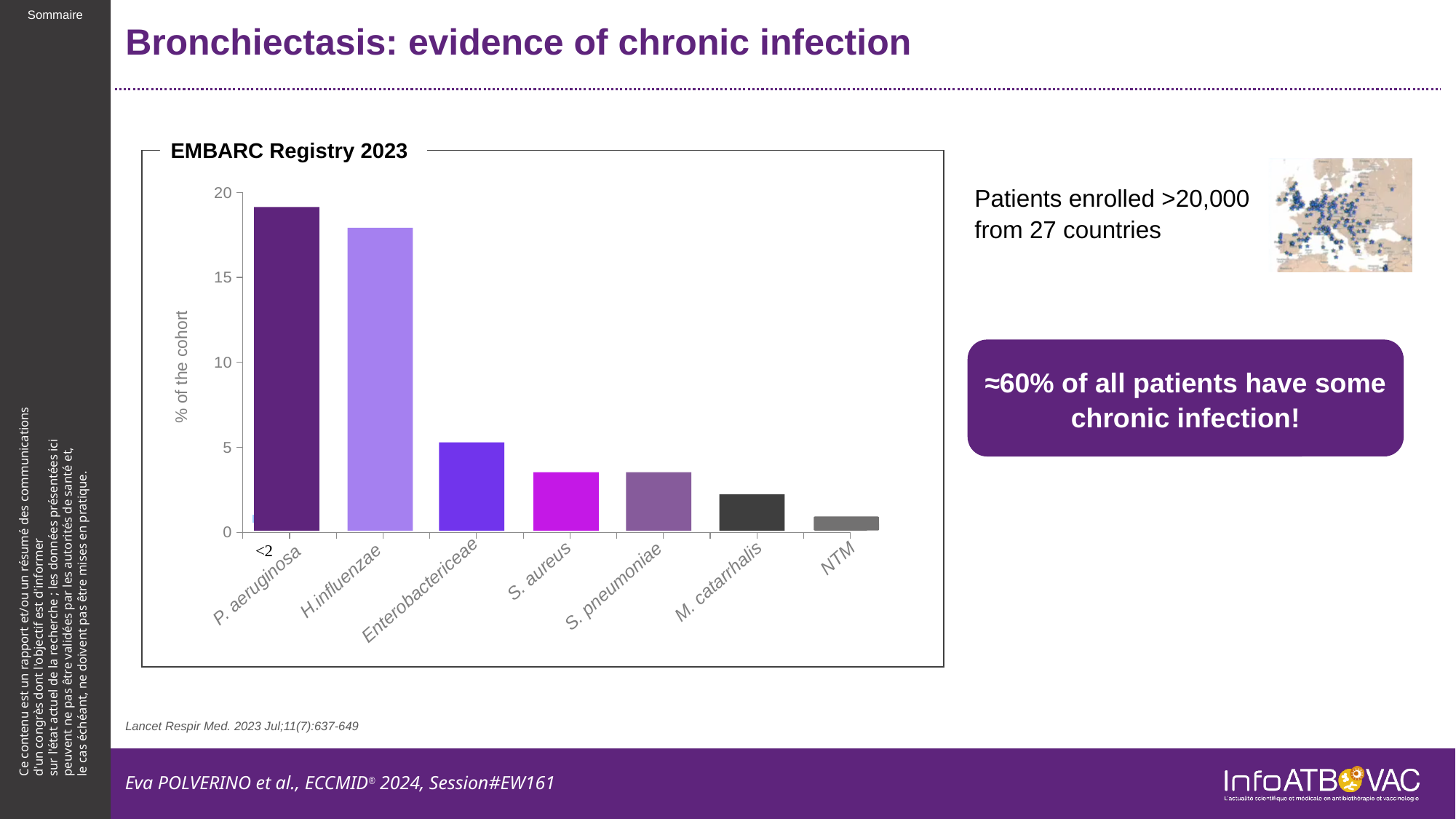
Is the value for NTM greater or less than 5? less Is the value for H.influenzae greater or less than 15? greater Which has a larger value, P. aeruginosa or Enterobactericeae? P. aeruginosa Is the value for P. aeruginosa greater or less than 15? greater What is the title of the chart? EMBARC Registry 2023 What kind of chart is shown on the slide? bar chart Do the bar values rise or fall moving from left to right along the x axis? fall Which pathogen has the lowest percentage of the cohort in the chart? NTM How many categories (pathogens) are shown on the x axis of the chart? 7 Which has a larger value, M. catarrhalis or NTM? M. catarrhalis Which pathogen has the highest percentage of the cohort in the chart? P. aeruginosa